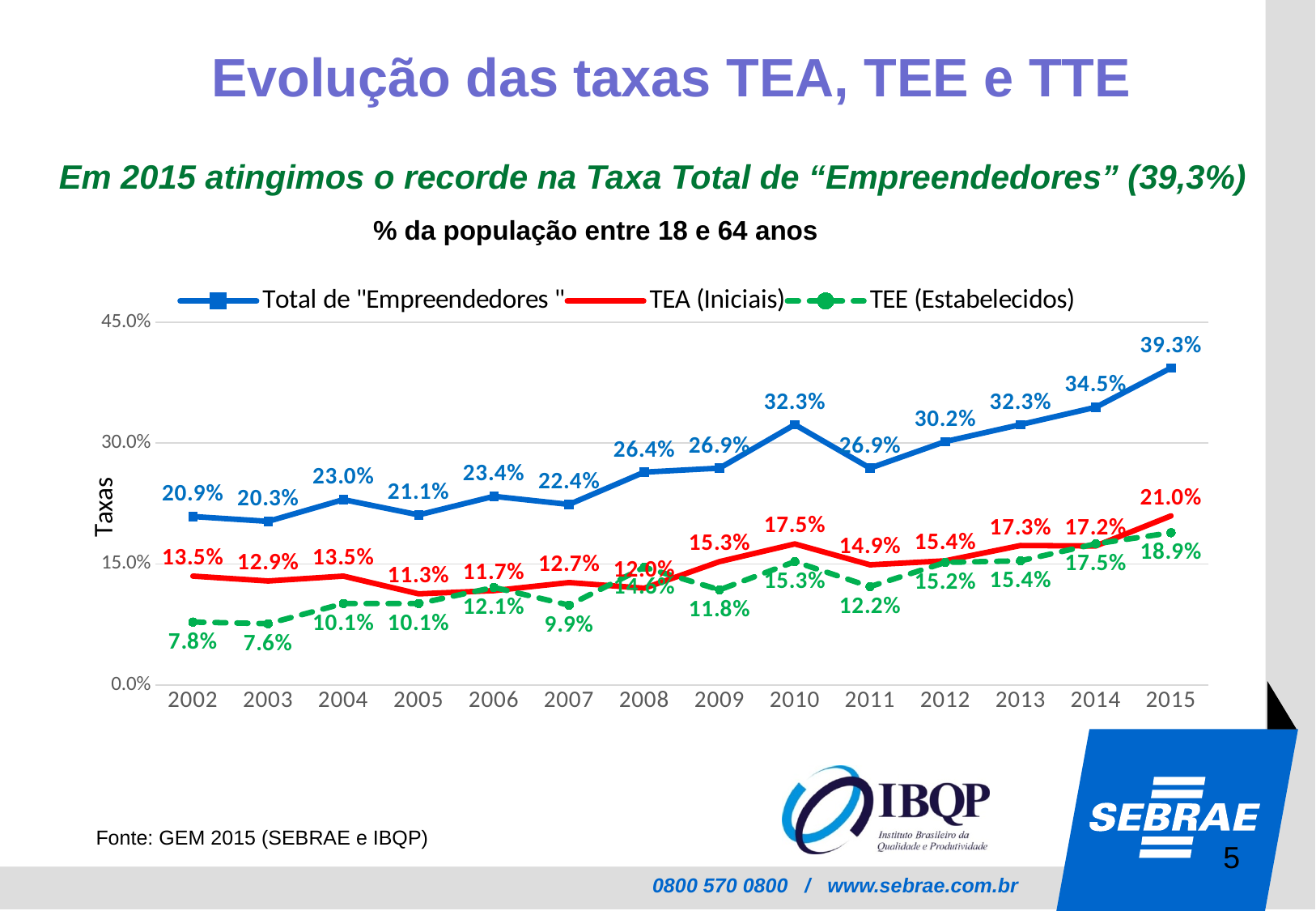
What is the value of Total de "Empreendedores" in 2015? 39.3% What kind of chart is shown on the slide? line chart In which year is TEA (Iniciais) lowest? 2005 What is the label on the y axis? Taxas How many years are shown on the x axis? 14 In which year is TEE (Estabelecidos) lowest? 2003 In 2010, which is larger: TEA (Iniciais) or TEE (Estabelecidos)? TEA (Iniciais) In which year is Total de "Empreendedores" highest? 2015 By how much did Total de "Empreendedores" increase from 2014 to 2015? 4.8% How many series does the legend list? 3 What is the value of TEA (Iniciais) in 2010? 17.5% What is the value of TEE (Estabelecidos) in 2002? 7.8%